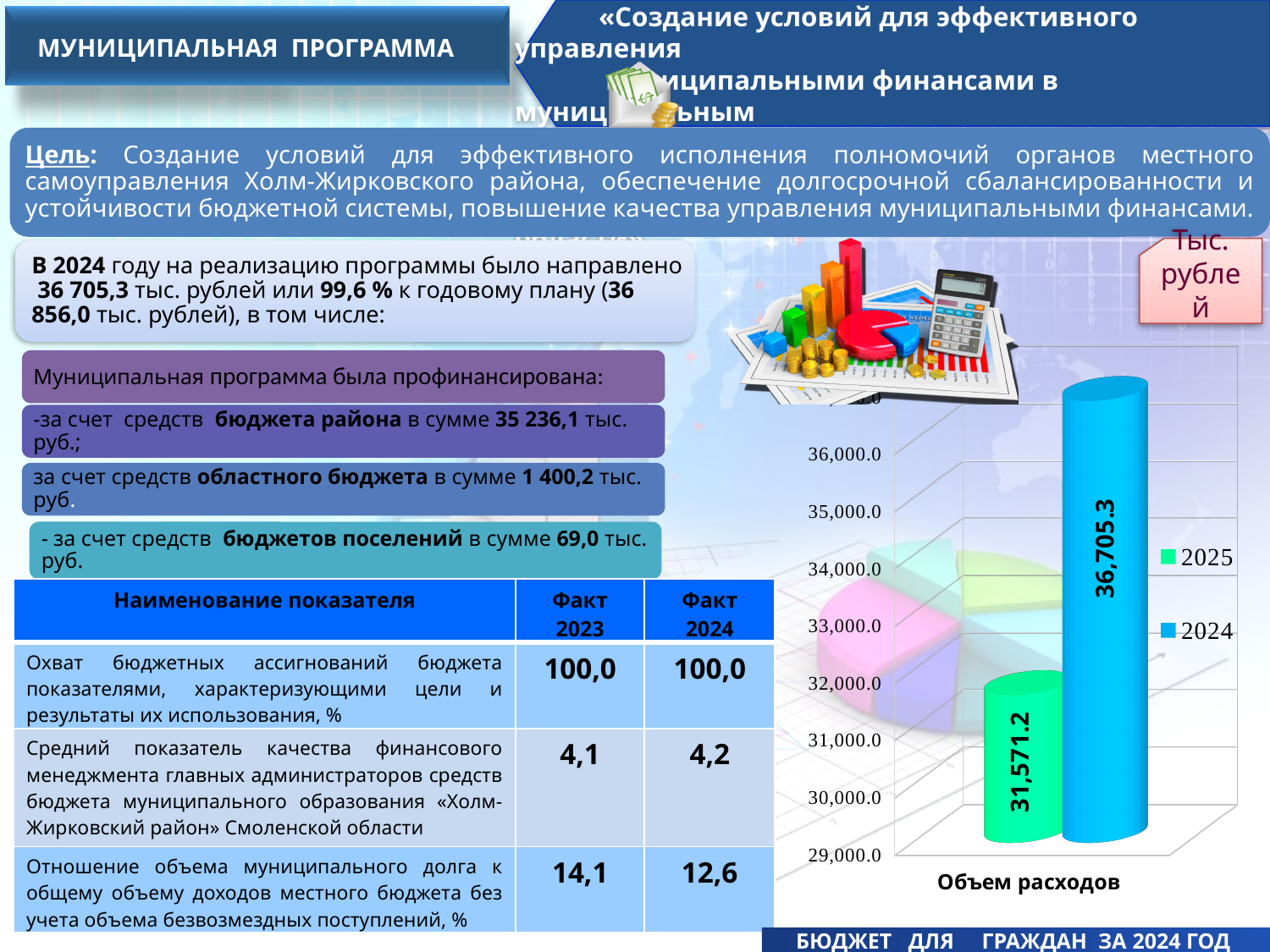
What is the difference between the 2024 and 2025 values in the chart? 5,134.1 How many series does the chart legend list? 2 What colour is the 2024 series in the chart? blue What is the category label on the x axis of the chart? Объем расходов Is the value for 2025 in the chart greater or less than 32,000.0? less Is the value for 2024 in the chart greater or less than 36,000.0? greater What is the value of the 2024 bar in the chart? 36,705.3 Which series has the higher value in the chart, 2024 or 2025? 2024 How many categories are shown on the x axis of the chart? 1 What type of chart is shown on the slide? bar chart Which series has the lowest value in the chart? 2025 What is the value of the 2025 bar in the chart? 31,571.2